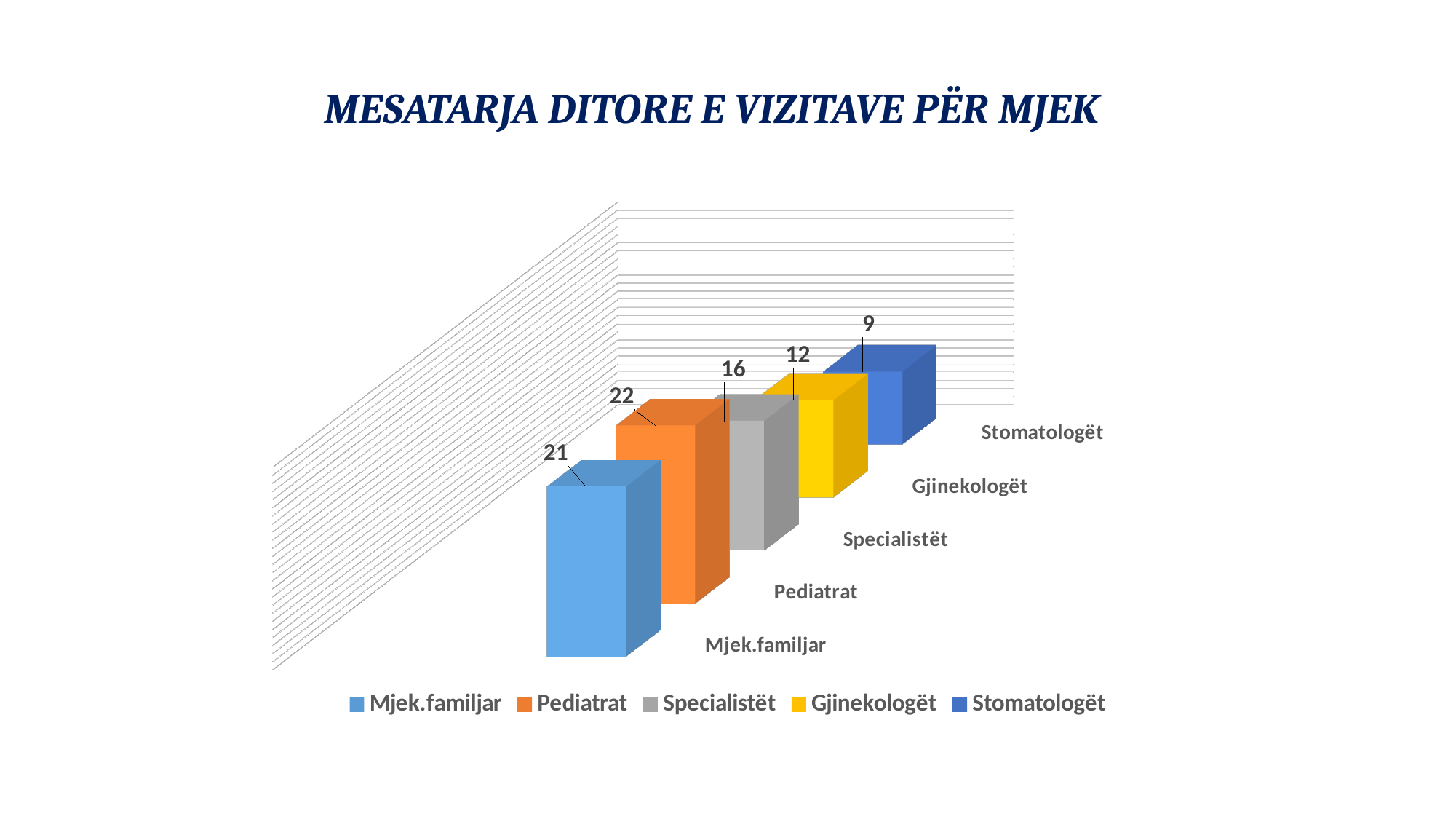
What is the title of the chart? MESATARJA DITORE E VIZITAVE PËR MJEK Which is larger, the value for Specialistët or the value for Gjinekologët? Specialistët What is the value for Gjinekologët? 12 What is the value for Pediatrat? 22 Which category has the lowest value? Stomatologët Which category has the highest value? Pediatrat What is the difference between the values for Pediatrat and Stomatologët? 13 What kind of chart is shown on the slide? Bar chart What is the value for Stomatologët? 9 How many categories are shown in the chart? 5 What is the value for Specialistët? 16 What is the value for Mjek.familjar? 21